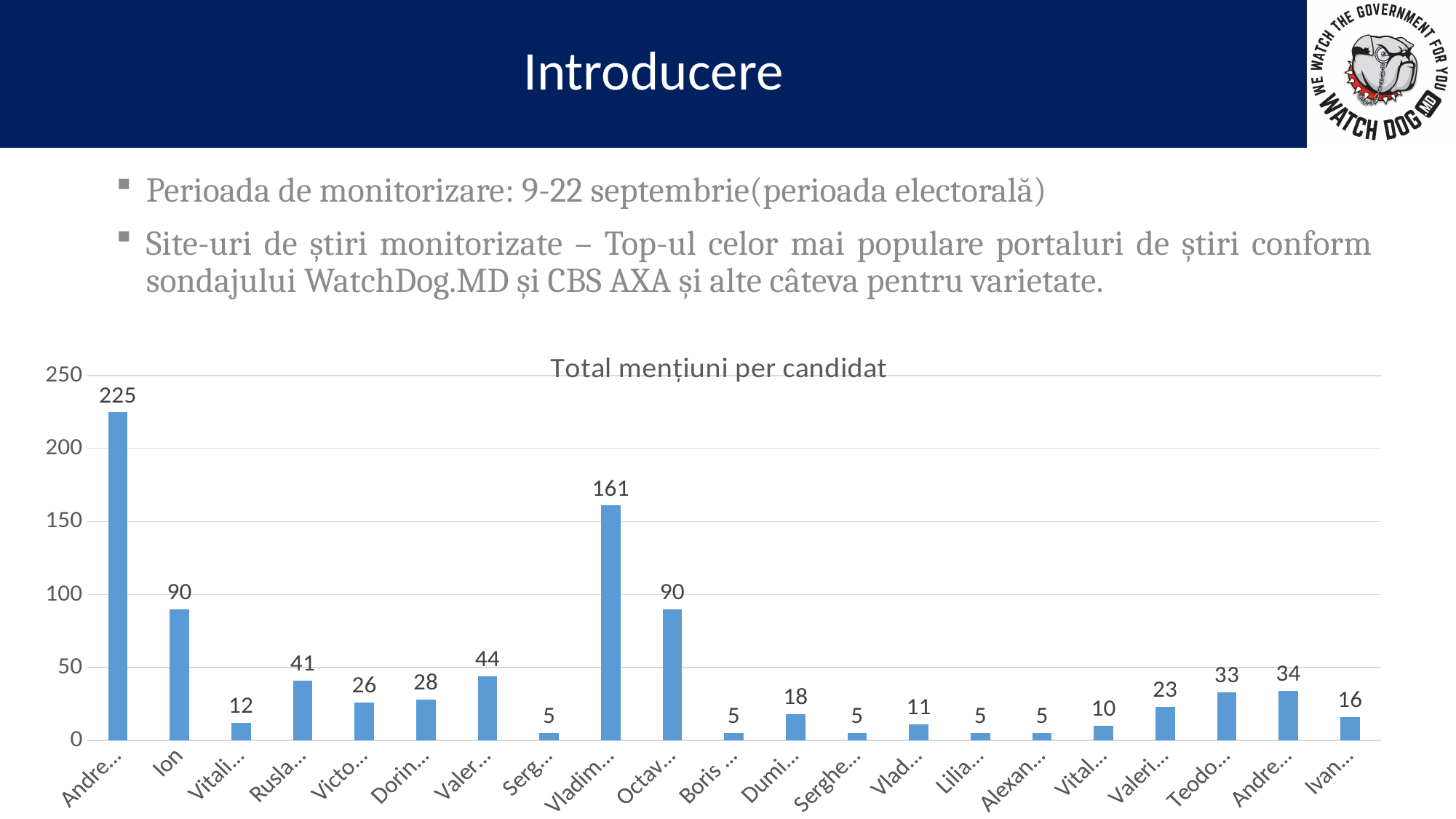
What is the highest value shown in the chart 'Total mențiuni per candidat'? 225 What kind of chart is shown on the slide? bar chart Is the value for Ion in the chart 'Total mențiuni per candidat' greater or less than 50? greater What is the lowest value shown in the chart 'Total mențiuni per candidat'? 5 Which is larger in the chart 'Total mențiuni per candidat': the value for Ion or the value of the first bar on the left? the first bar What is the value of the last bar on the right in the chart 'Total mențiuni per candidat'? 16 What is the difference between the first bar (225) and the ninth bar (161) in the chart 'Total mențiuni per candidat'? 64 How many bars in the chart 'Total mențiuni per candidat' have a value of 5? 5 How many bars (candidates) are shown in the chart 'Total mențiuni per candidat'? 21 What is the difference between the tallest bar (225) and the value for Ion in the chart 'Total mențiuni per candidat'? 135 What is the value for Ion in the chart 'Total mențiuni per candidat'? 90 What is the title of the chart on the slide? Total mențiuni per candidat